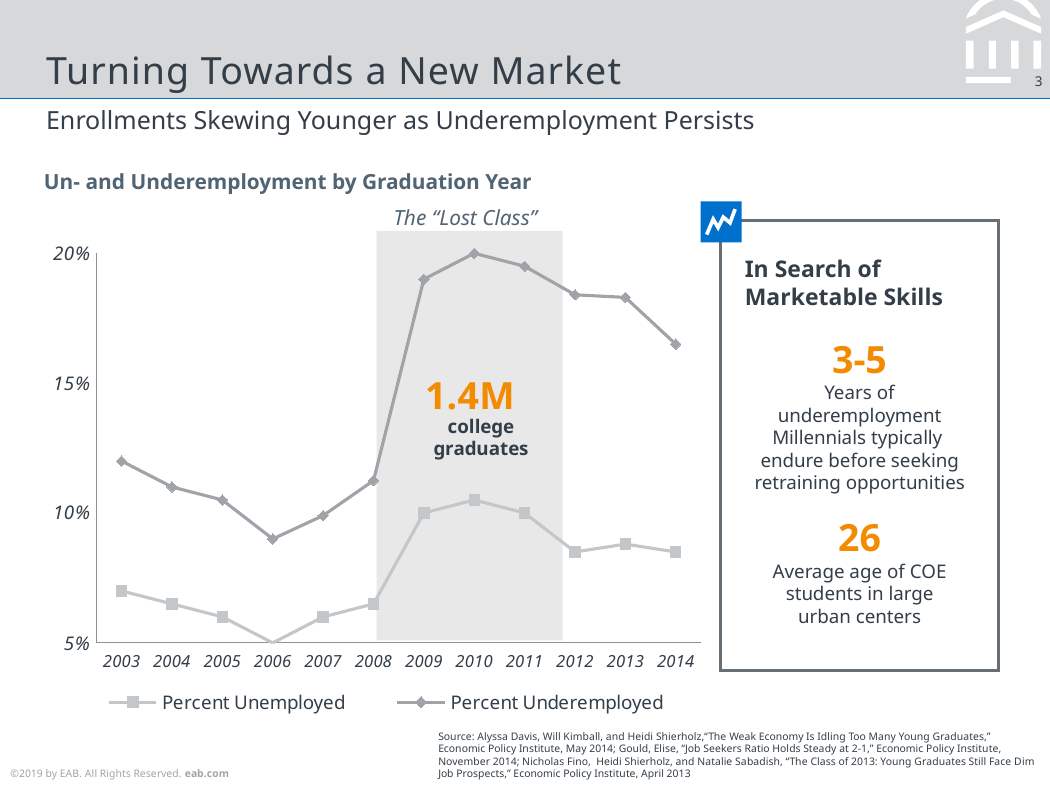
What is the title of the chart? Un- and Underemployment by Graduation Year In which year is Percent Underemployed lowest? 2006 How many graduation years are plotted along the x axis? 12 Is the Percent Underemployed value for 2006 greater or less than 10%? less In 2010, which is larger: Percent Unemployed or Percent Underemployed? Percent Underemployed In which year is Percent Unemployed lowest? 2006 Does Percent Underemployed rise or fall from 2010 to 2014? fall Is the Percent Underemployed value for 2009 greater or less than 15%? greater Is the Percent Unemployed value for 2003 greater or less than 10%? less In which year is Percent Underemployed highest? 2010 What kind of chart is shown on the slide? line chart How many series does the chart's legend list? 2